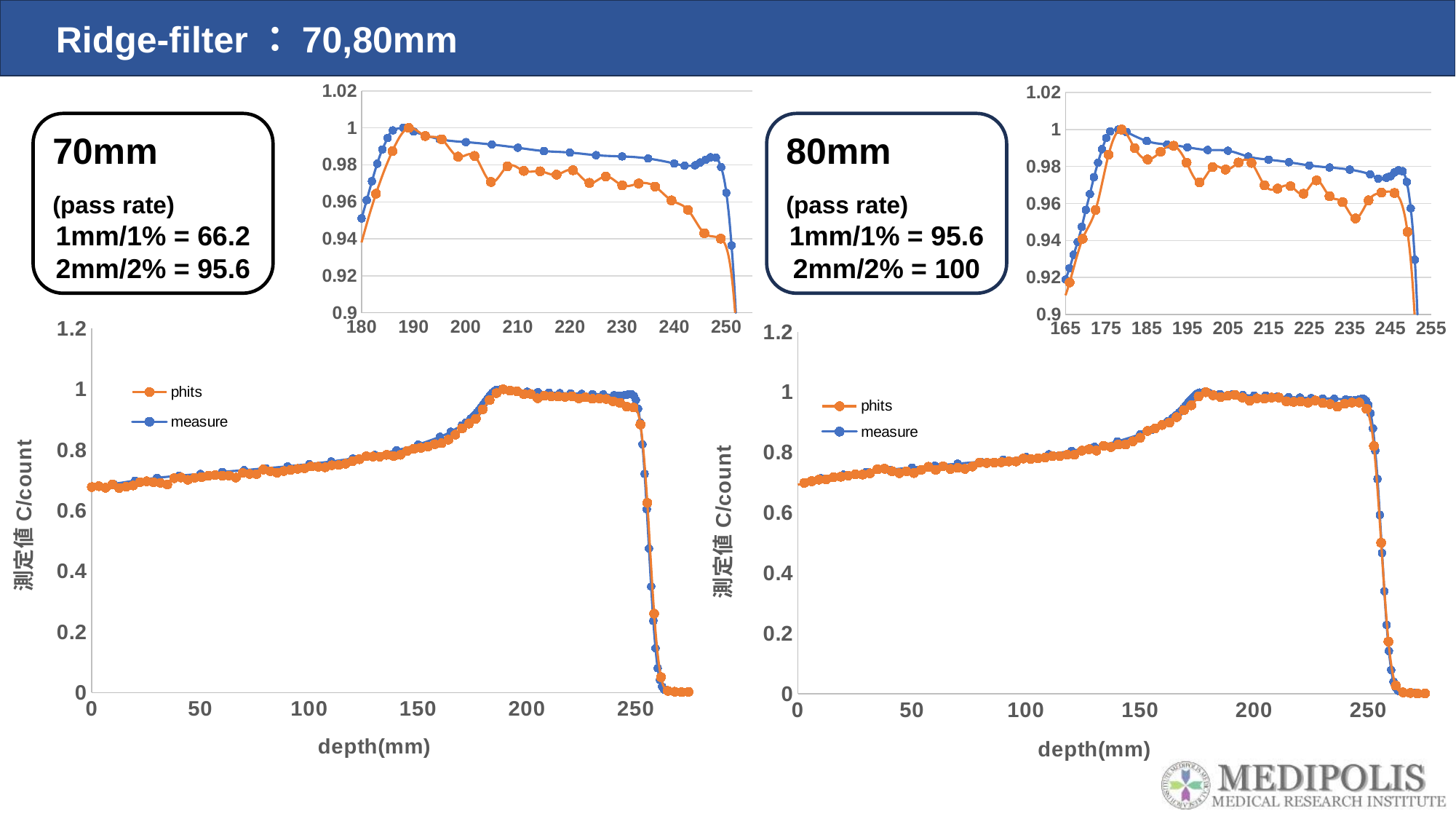
What kind of chart is the large 70mm chart on the bottom left of the slide? line chart In the 80mm chart on the bottom right, is the value for measure at depth 250 greater or less than 0.8? greater In the 70mm chart on the bottom left, is the value for phits at depth 0 greater or less than 0.6? greater In the 70mm chart on the bottom left, is the value for measure at depth 100 greater or less than 0.8? less What kind of chart is the inset chart above the 80mm chart on the top right? line chart In the 70mm chart on the bottom left, do the values rise or fall as depth increases from 0 to 150 mm? rise In the inset chart above the 70mm chart, which series has the larger value at 240 on the x axis, phits or measure? measure In the 70mm chart on the bottom left, do the values rise or fall as depth increases beyond 250 mm? fall How many series does the legend of the 70mm chart on the bottom left list? 2 What is the x-axis label of the 70mm chart on the bottom left? depth(mm) What are the two legend entries in the 80mm chart on the bottom right? phits and measure